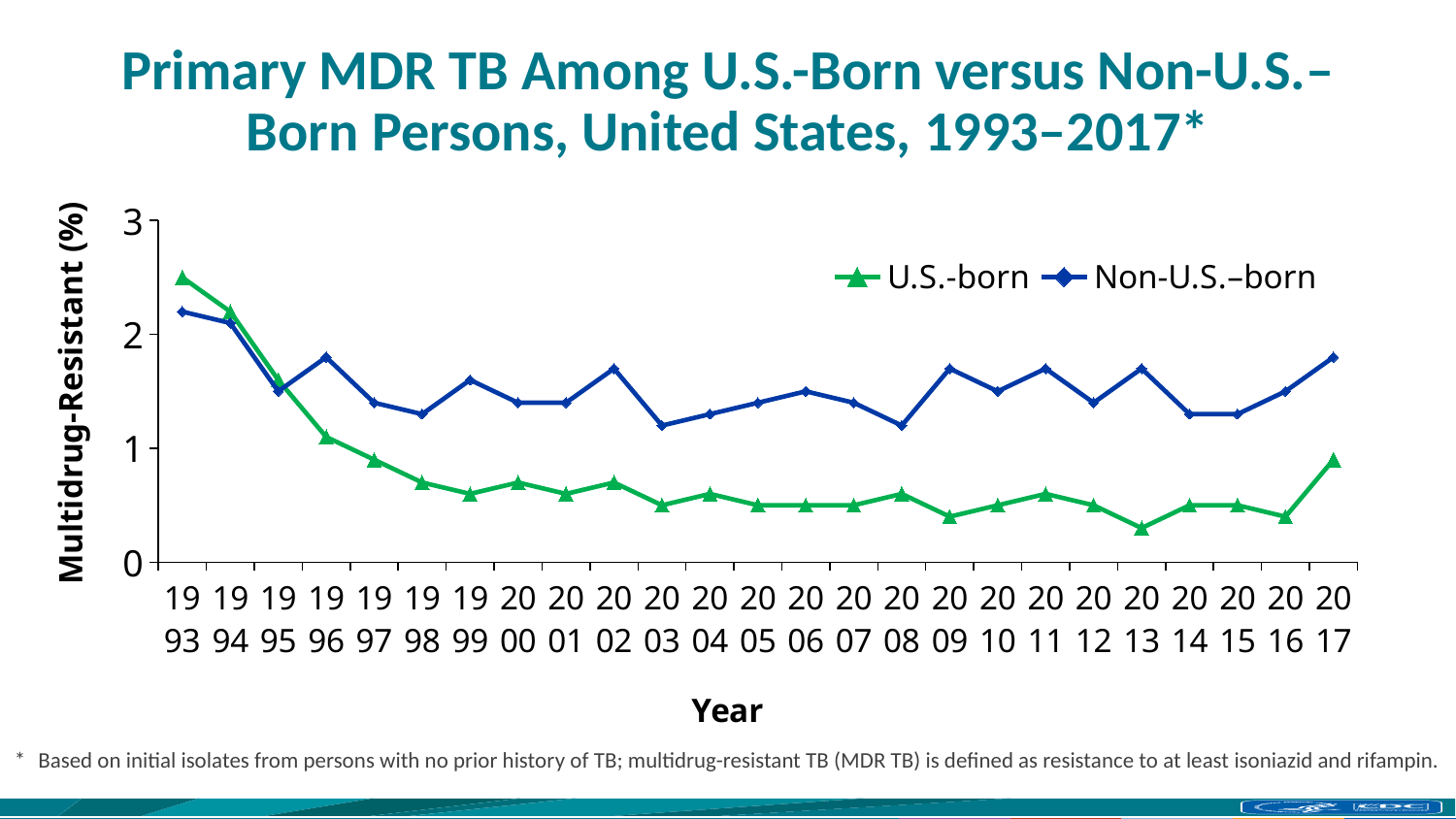
How many years are plotted along the x axis? 25 What is the label of the y axis? Multidrug-Resistant (%) How many series does the legend list? 2 What kind of chart is shown on the slide? Line chart Is the value for Non-U.S.–born in 2017 greater or less than 1? greater Does the U.S.-born series rise or fall from 1993 to 1998? Fall Is the value for Non-U.S.–born in 2008 greater or less than 2? less Which series has the highest value in 1993? U.S.-born Is the value for U.S.-born in 1993 greater or less than 2? greater In which year is the U.S.-born series at its highest? 1993 In 2017, which series has the larger value, U.S.-born or Non-U.S.–born? Non-U.S.–born